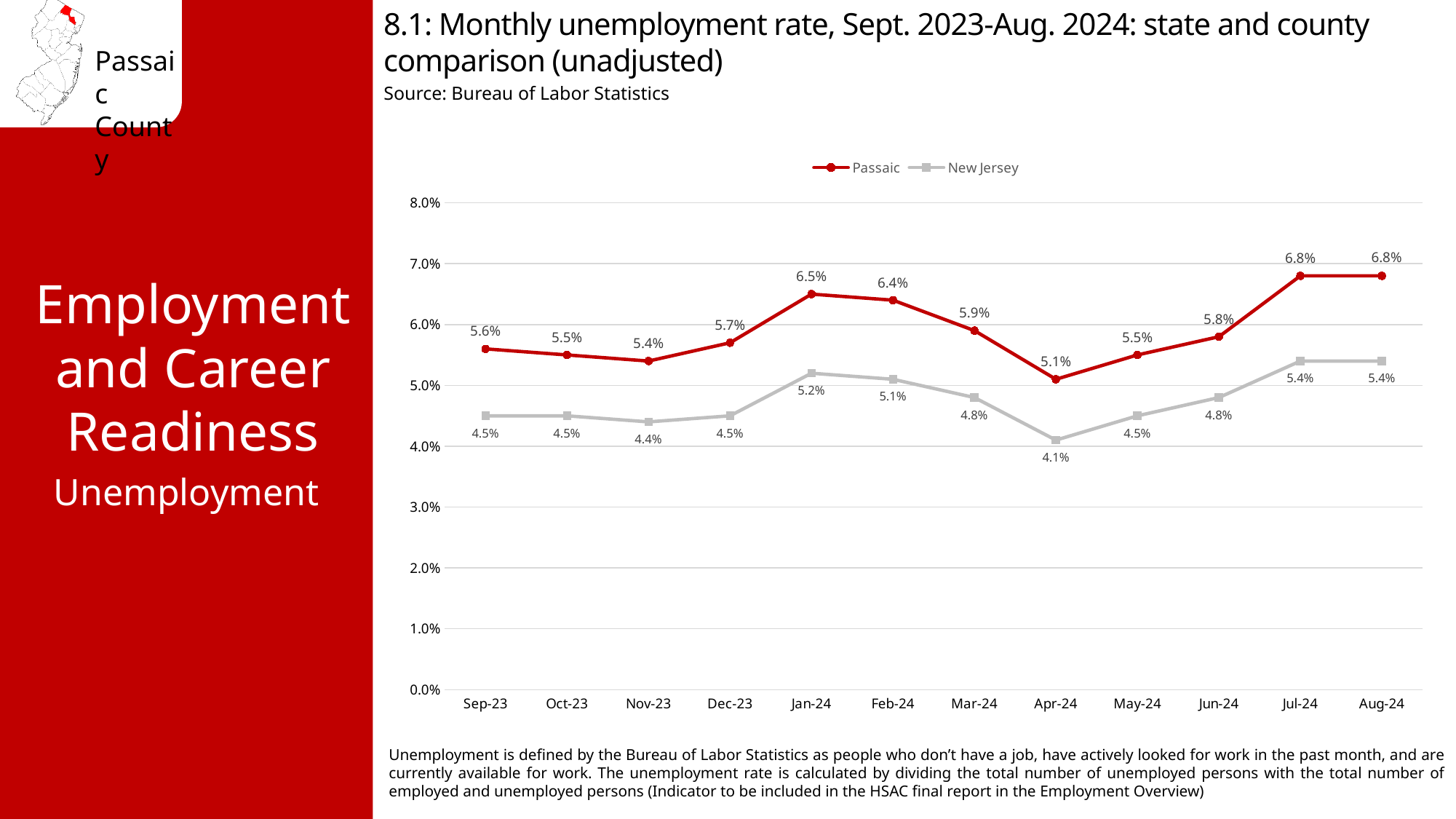
What is the difference between the Passaic rate in Jan-24 and the Passaic rate in Apr-24? 1.4% Which series had the higher unemployment rate in Mar-24, Passaic or New Jersey? Passaic Is the Passaic unemployment rate in Jul-24 greater or less than 6.0%? greater What type of chart is shown on the slide? Line chart How many series does the legend list? 2 What was the Passaic unemployment rate in Nov-23? 5.4% What was the Passaic unemployment rate in Jan-24? 6.5% What is the difference between the Passaic and New Jersey unemployment rates in Aug-24? 1.4% In which month was the New Jersey unemployment rate lowest? Apr-24 How many months are shown on the x axis? 12 What was the New Jersey unemployment rate in Apr-24? 4.1% In which month was the Passaic unemployment rate lowest? Apr-24